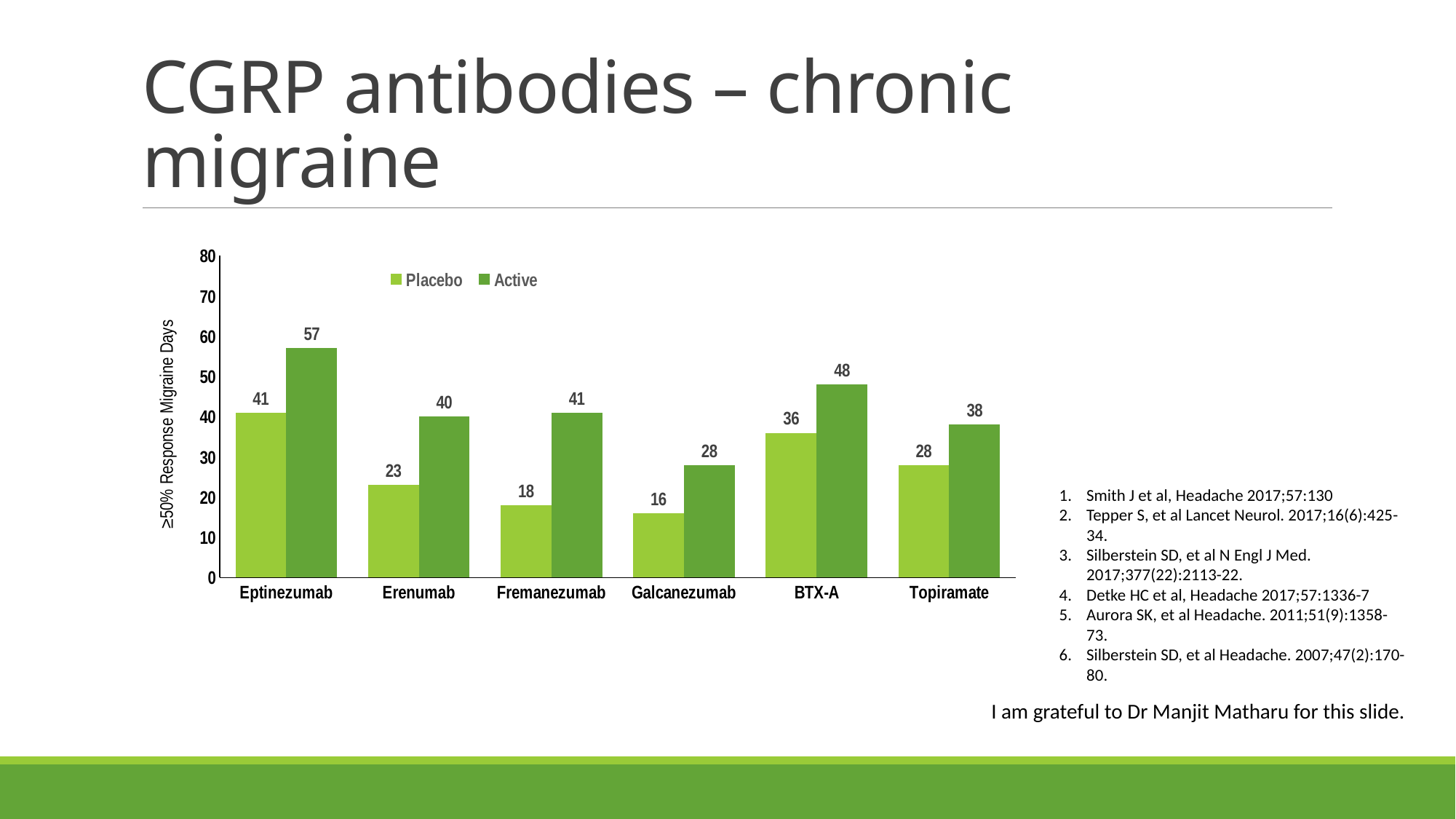
What is the difference between the Active and Placebo values for Fremanezumab? 23 What kind of chart is shown on the slide? Bar chart What is the Active value for BTX-A? 48 How many categories are shown on the x axis? 6 How many series does the legend list? 2 Which is larger, the Placebo value for Eptinezumab or the Placebo value for BTX-A? Eptinezumab What are the two series listed in the legend? Placebo and Active Which category has the highest Active value? Eptinezumab What is the y-axis label of the chart? ≥50% Response Migraine Days What is the Active value for Eptinezumab? 57 Which category has the lowest Placebo value? Galcanezumab What is the Placebo value for Galcanezumab? 16